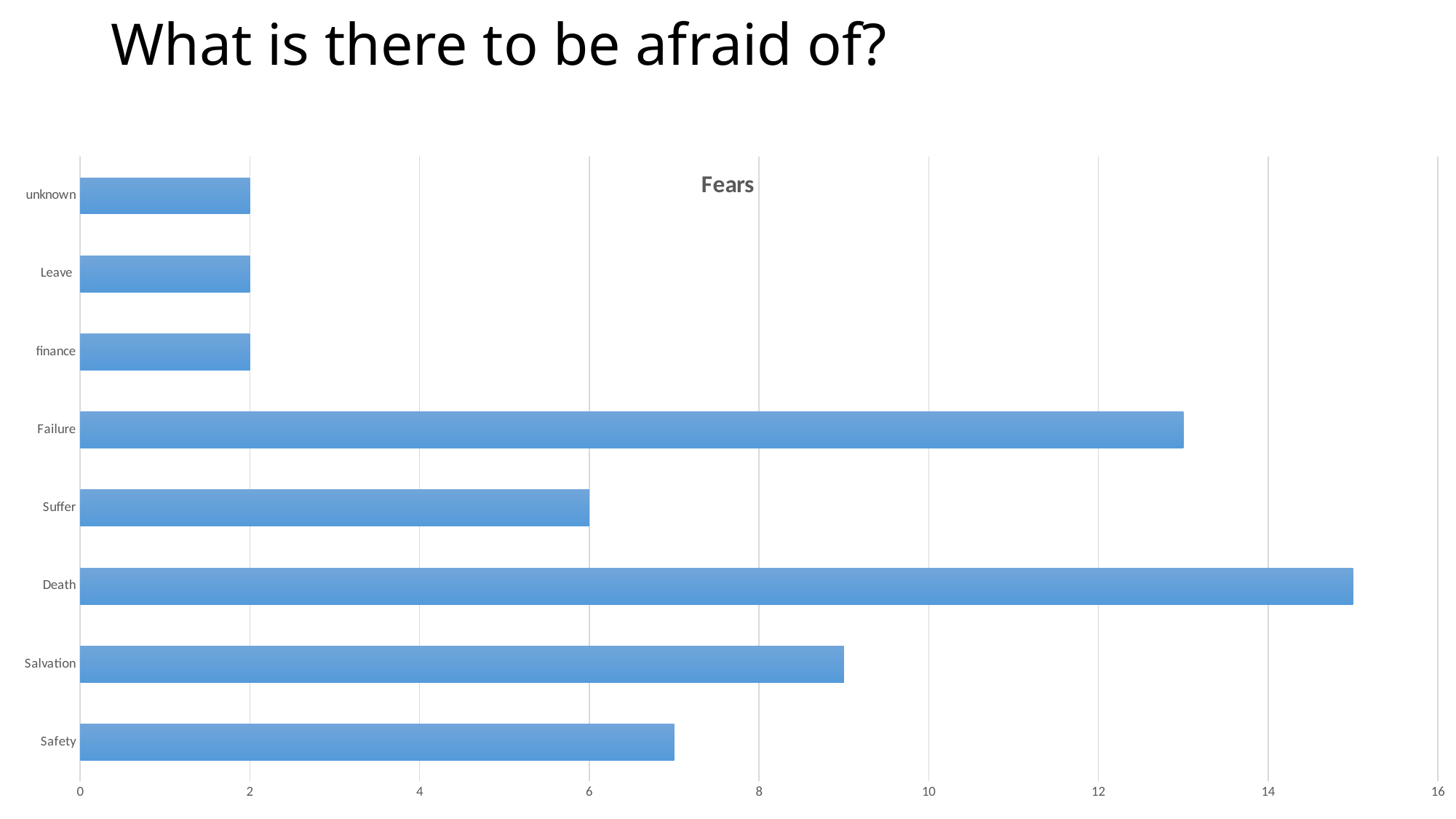
Which category has the highest value? Death What is the value for unknown? 2 What is the value for finance? 2 How many categories are plotted in the chart? 8 What is the difference between the values for Suffer and Leave? 4 What is the title of the chart? Fears Is the value for Failure greater or less than 12? greater Which is larger, the value for Death or the value for Failure? Death Is the value for Salvation greater or less than 10? less What is the value for Suffer? 6 What kind of chart is shown on the slide? bar chart Which is larger, the value for Safety or the value for Salvation? Salvation